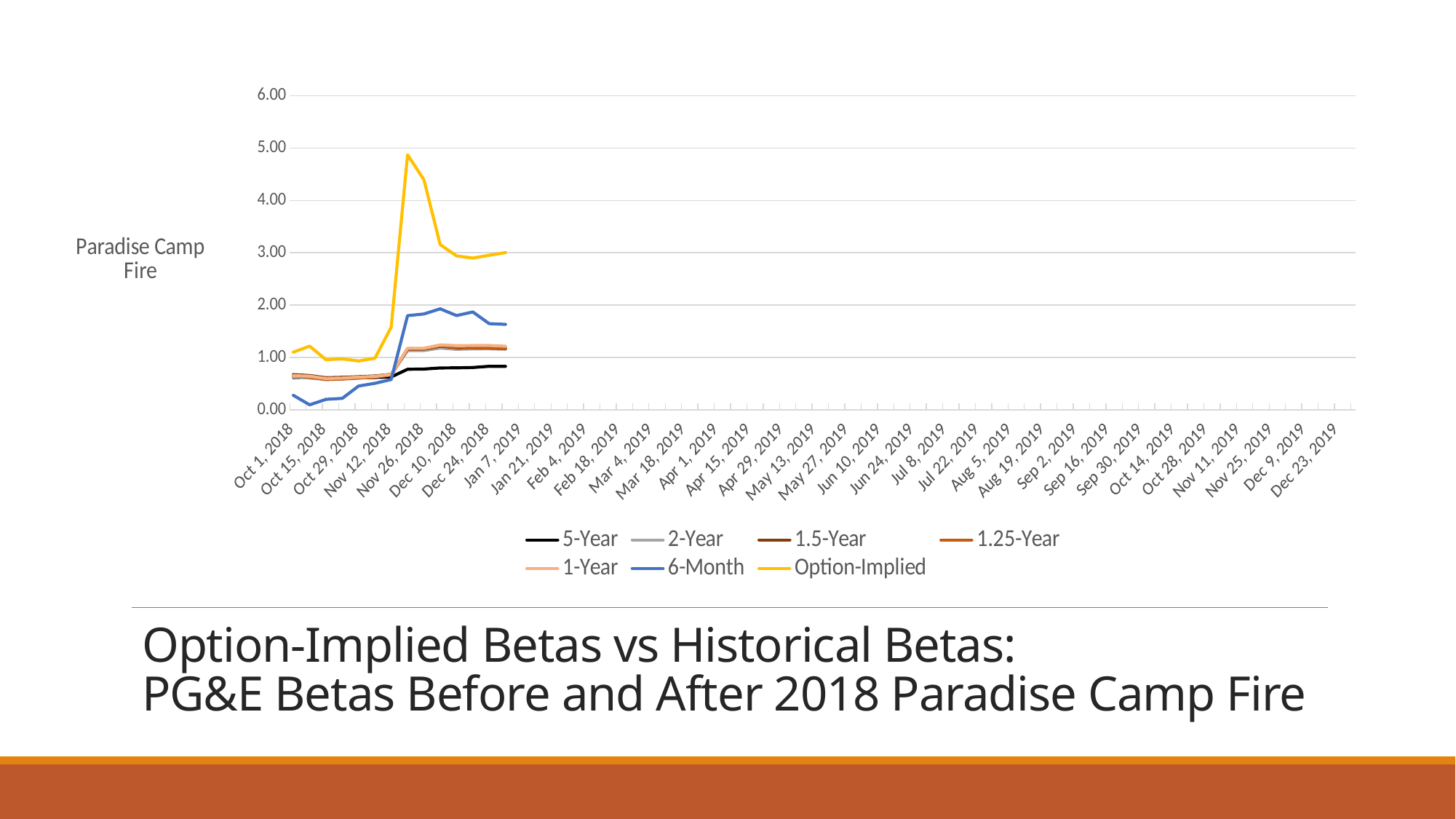
What colour is the Option-Implied series line? yellow Does the 5-Year series rise or fall from Oct 1, 2018 to Jan 7, 2019? rise What is the highest value shown on the y axis? 6.00 Which series has the lowest value at the start of the chart (Oct 1, 2018)? 6-Month Which series reaches the highest value on the chart? Option-Implied How many series does the legend list? 7 Is the value of the 5-Year series at Jan 7, 2019 greater or less than 1.00? less Around Dec 10, 2018, which series is larger: Option-Implied or 5-Year? Option-Implied What kind of chart is shown on the slide? line chart Is the peak value of the Option-Implied series greater or less than 4.00? greater Is the value of the Option-Implied series at Jan 7, 2019 greater or less than 2.00? greater